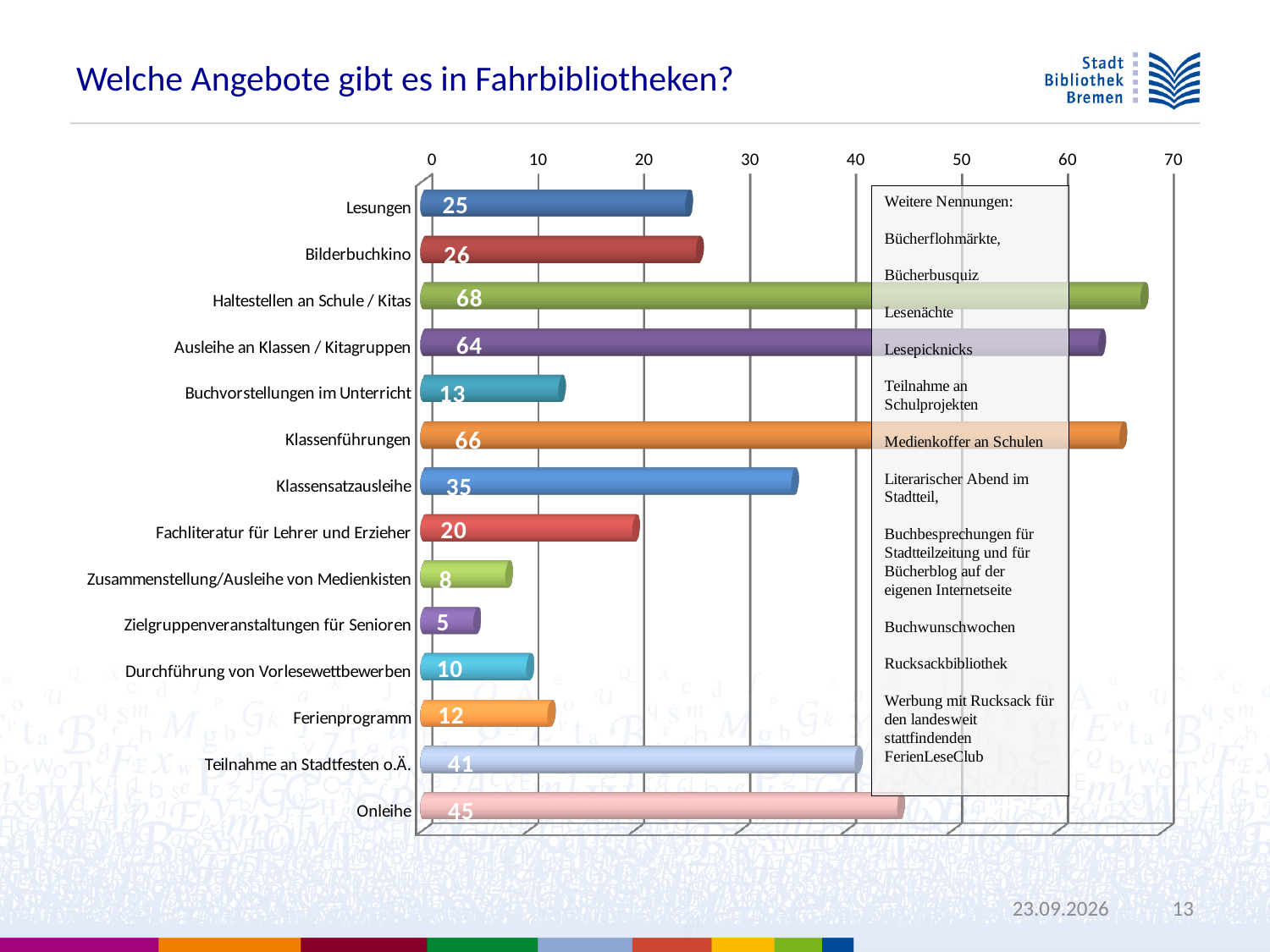
What is the difference between the values for Onleihe and Teilnahme an Stadtfesten o.Ä.? 4 What kind of chart is shown on the slide? bar chart Which is larger, the value for Klassensatzausleihe or the value for Bilderbuchkino? Klassensatzausleihe How many categories are shown in the chart? 14 What is the value for Buchvorstellungen im Unterricht? 13 Is the value for Teilnahme an Stadtfesten o.Ä. greater or less than 30? greater What is the value for Klassenführungen? 66 Which category has the highest value? Haltestellen an Schule / Kitas Which category has the lowest value? Zielgruppenveranstaltungen für Senioren What is the value for Onleihe? 45 What is the difference between the values for Haltestellen an Schule / Kitas and Ausleihe an Klassen / Kitagruppen? 4 What is the title of the slide? Welche Angebote gibt es in Fahrbibliotheken?